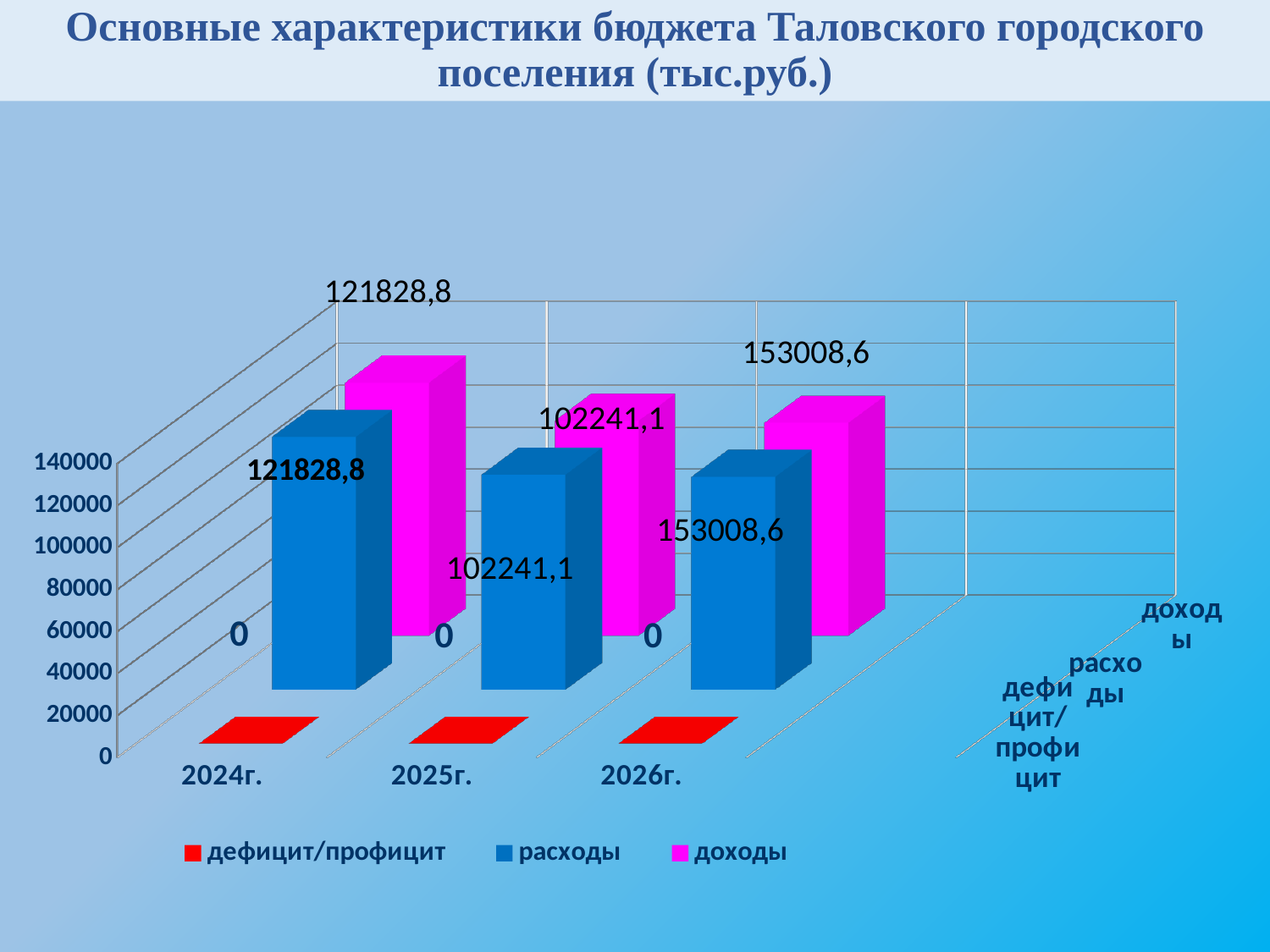
What is the value of доходы for 2024г.? 121828,8 How many years are shown on the x axis? 3 What is the value of расходы for 2025г.? 102241,1 What is the difference between доходы in 2026г. and доходы in 2025г.? 50767,5 What is the value of доходы for 2026г.? 153008,6 Which colour represents the series доходы in the legend? magenta How many series does the legend list? 3 What is the value of дефицит/профицит for 2025г.? 0 What kind of chart is shown on the slide? bar chart